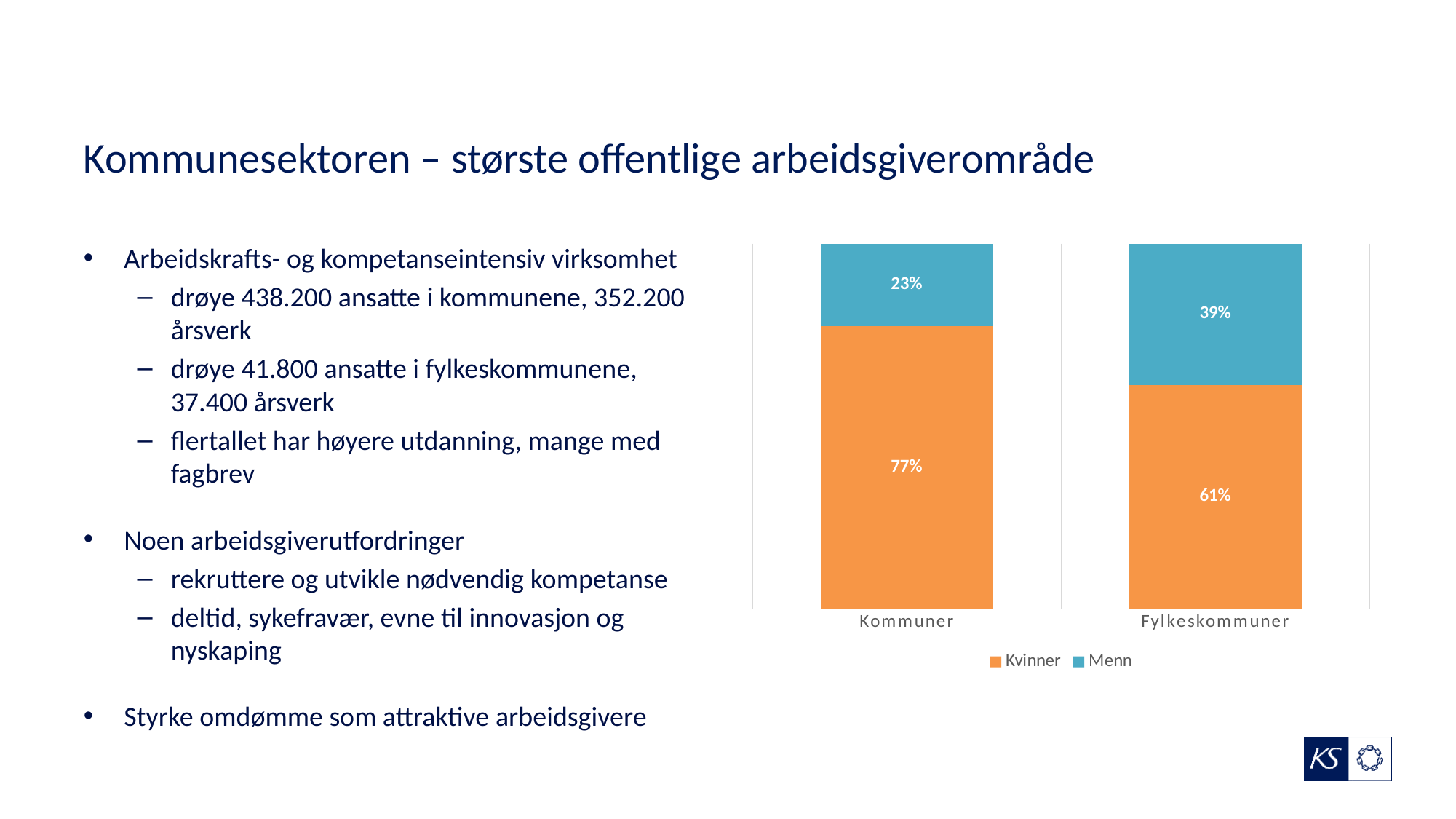
What is the value for Menn in Fylkeskommuner? 39% How many categories are shown on the x axis? 2 What is the total of the stacked bar for Kommuner? 100% What is the value for Kvinner in Kommuner? 77% What is the value for Kvinner in Fylkeskommuner? 61% What is the difference between Kvinner and Menn in Fylkeskommuner? 22% How many series does the legend list? 2 What is the value for Menn in Kommuner? 23% Which category has the higher share of Menn, Kommuner or Fylkeskommuner? Fylkeskommuner What kind of chart is shown on the slide? Stacked bar chart Which category has the highest value for Kvinner? Kommuner What is the difference between the Kvinner share in Kommuner and in Fylkeskommuner? 16%